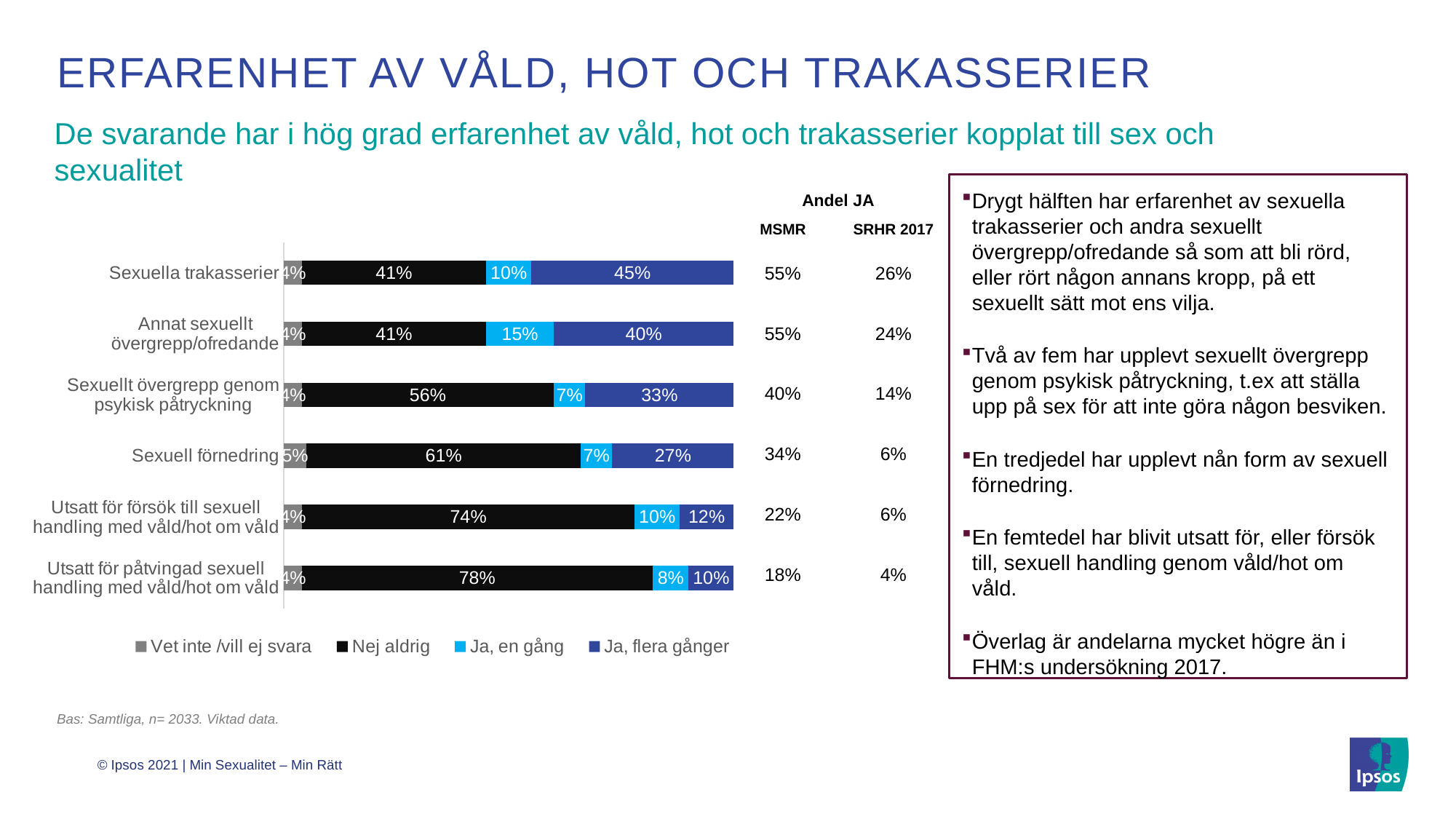
Which is larger: the "Ja, flera gånger" value for "Sexuellt övergrepp genom psykisk påtryckning" or for "Sexuell förnedring"? Sexuellt övergrepp genom psykisk påtryckning How many categories does the chart show? 6 How many series does the legend list? 4 What is the combined value of "Ja, en gång" and "Ja, flera gånger" for "Sexuell förnedring"? 34% Which category has the highest value for "Nej aldrig"? Utsatt för påtvingad sexuell handling med våld/hot om våld What kind of chart is shown on the slide? Stacked bar chart Which category has the lowest value for "Ja, flera gånger"? Utsatt för påtvingad sexuell handling med våld/hot om våld What is the value of "Ja, en gång" for "Annat sexuellt övergrepp/ofredande"? 15% What is the difference between the "Nej aldrig" values for "Sexuell förnedring" and "Sexuella trakasserier"? 20% What is the value of "Nej aldrig" for "Utsatt för påtvingad sexuell handling med våld/hot om våld"? 78% Which series is shown in black in the chart? Nej aldrig What is the value of "Ja, flera gånger" for "Sexuella trakasserier"? 45%